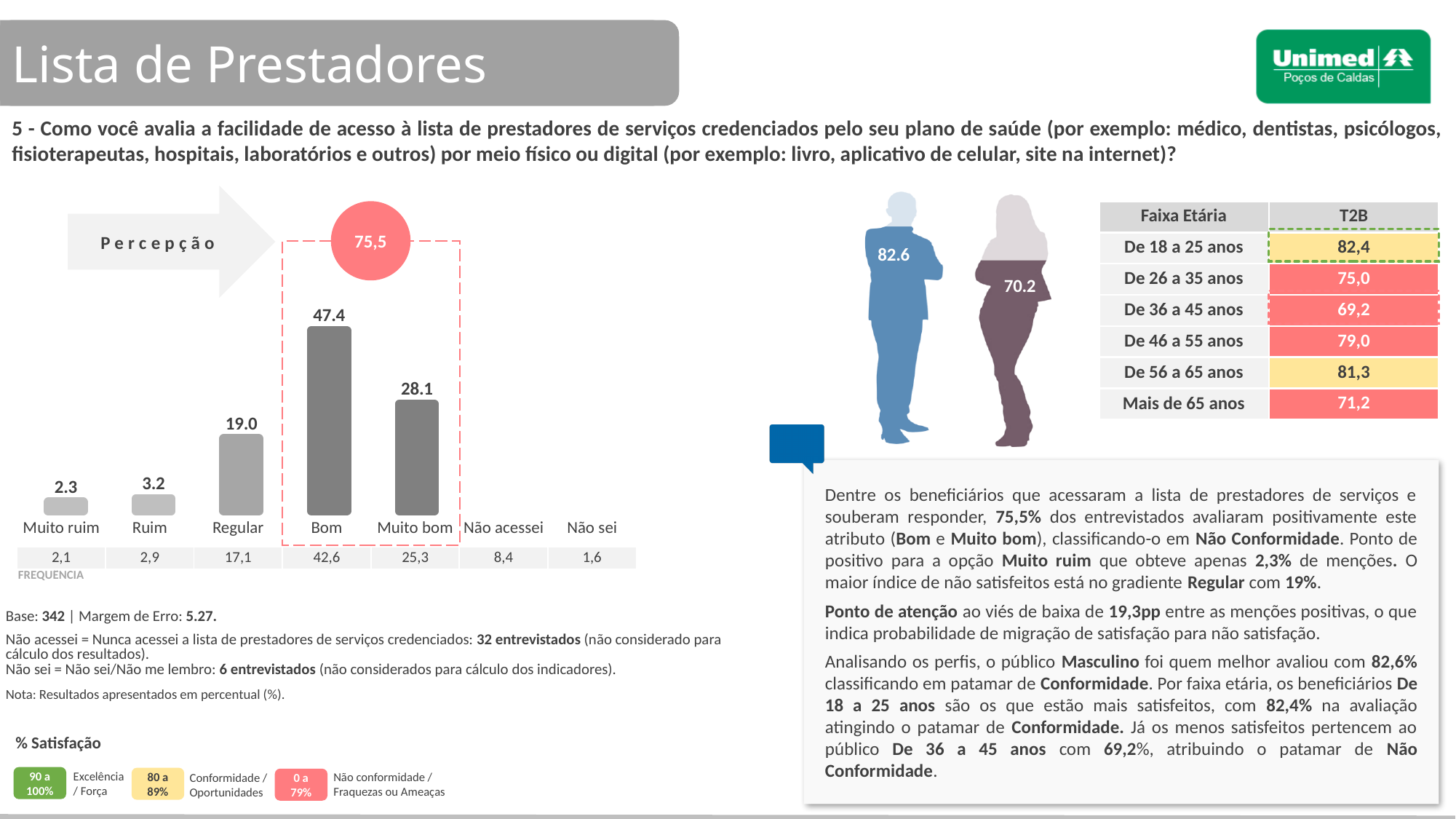
What is the difference between the values for Bom and Muito bom? 19.3 Which is larger, the value for Ruim or the value for Regular? Regular What is the frequency value shown below the Bom bar? 42,6 What is the value for Muito ruim in the bar chart? 2.3 Which category has the highest value in the bar chart? Bom What type of chart is shown on the left of the slide? Bar chart What is the value for Muito bom in the bar chart? 28.1 What label is shown in the arrow to the left of the bar chart? Percepção Which category has the lowest value among the plotted bars? Muito ruim What is the combined value of Bom and Muito bom shown in the circle above the dashed box? 75,5 What is the value for Bom in the bar chart? 47.4 What is the value for Regular in the bar chart? 19.0